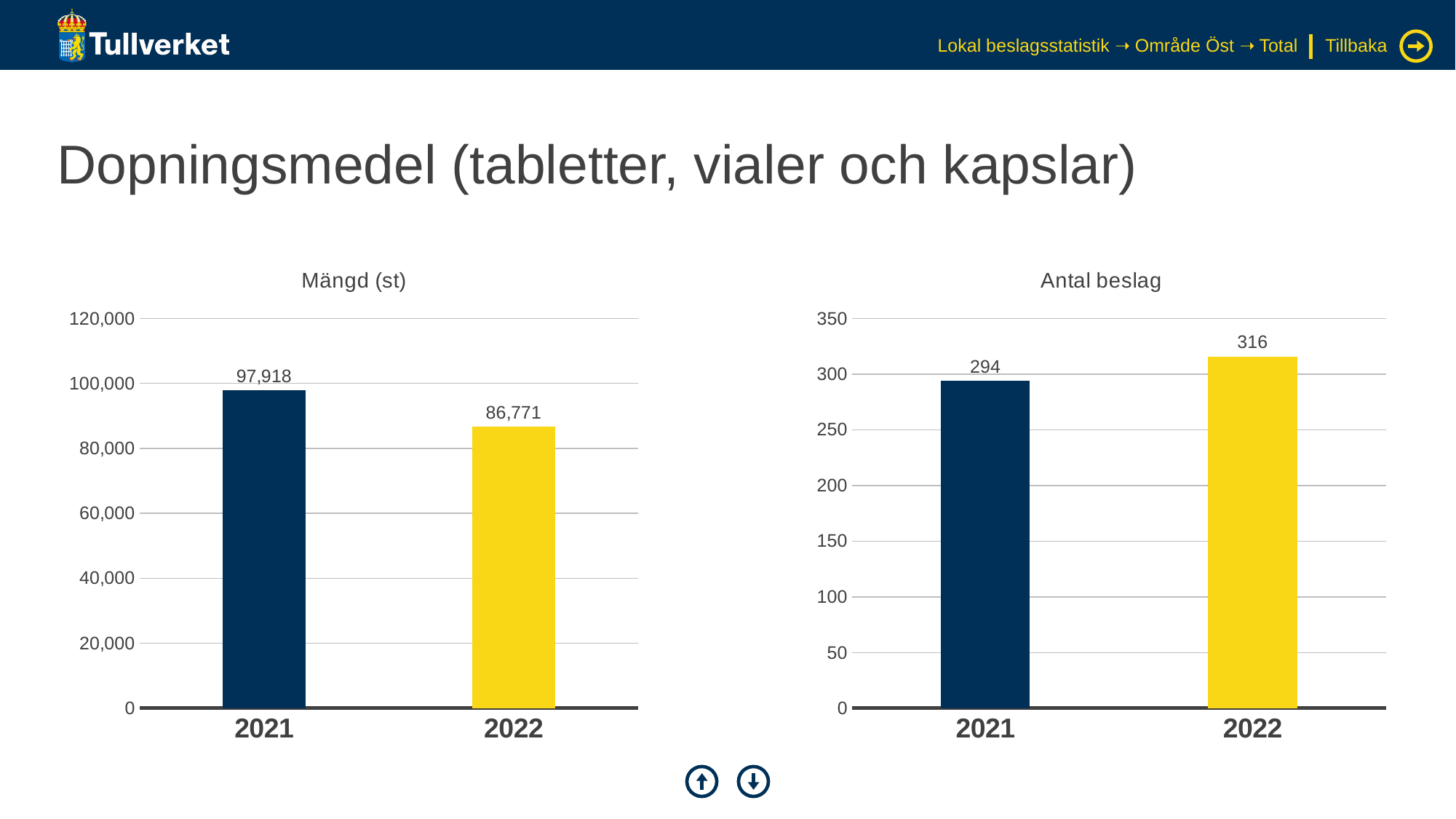
In the 'Mängd (st)' chart, do the values rise or fall from 2021 to 2022? fall In the 'Mängd (st)' chart, which year has the highest value? 2021 In the 'Antal beslag' chart, what is the value for 2022? 316 In the 'Antal beslag' chart, what is the difference between the 2022 and 2021 values? 22 In the 'Antal beslag' chart, what is the value for 2021? 294 What kind of chart is the 'Mängd (st)' chart? bar chart How many categories are shown on the x axis of the 'Antal beslag' chart? 2 In the 'Antal beslag' chart, is the value for 2022 greater or less than 300? greater In the 'Mängd (st)' chart, what is the difference between the 2021 and 2022 values? 11,147 In the 'Mängd (st)' chart, what is the value for 2021? 97,918 In the 'Mängd (st)' chart, what is the value for 2022? 86,771 In the 'Antal beslag' chart, which year has the lowest value? 2021